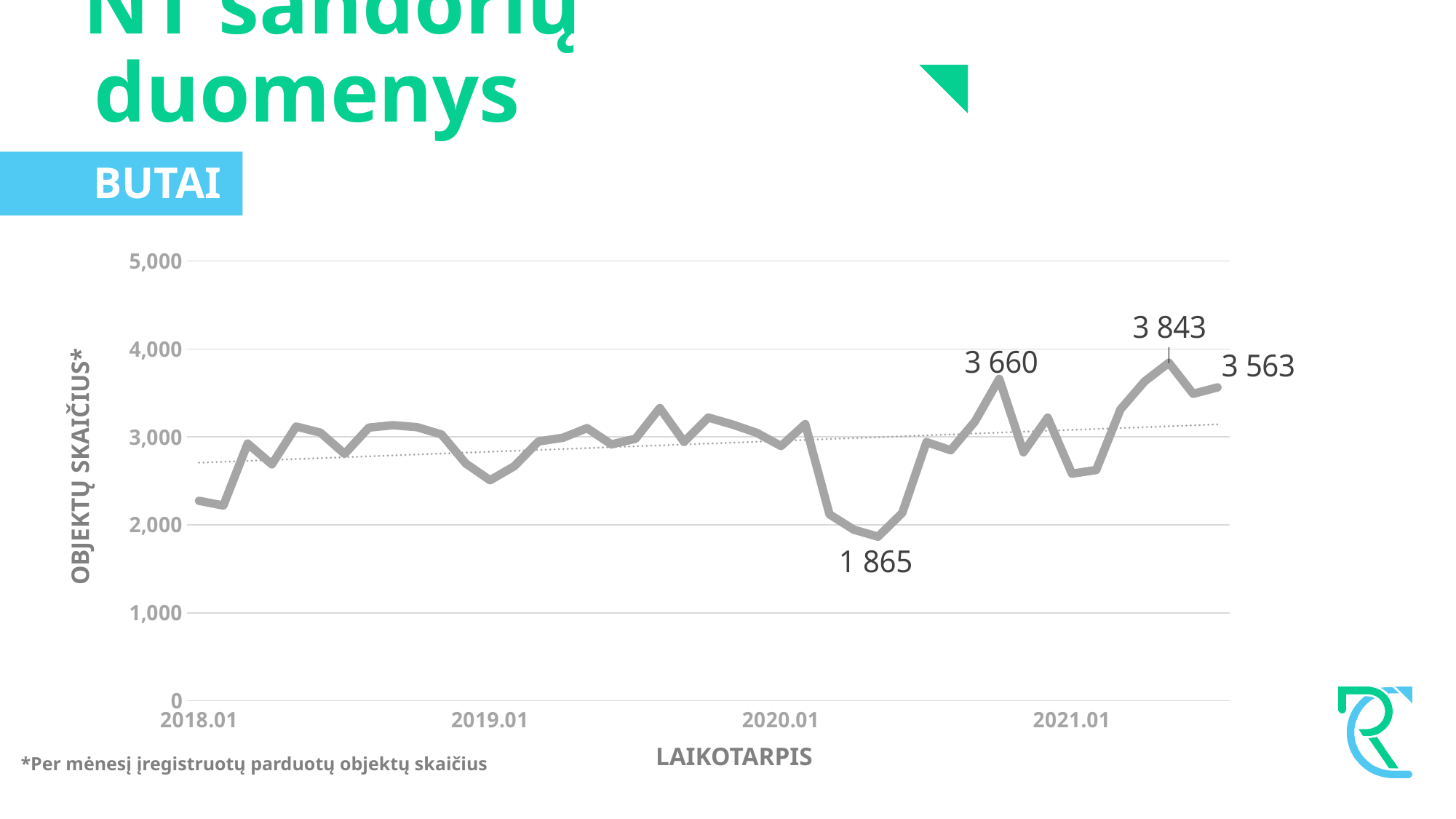
What is the highest value labelled on the chart? 3 843 Is the value at 2018.01 greater or less than 3,000? less Does the dotted trend line rise or fall from left to right? rises What is the lowest value labelled on the chart? 1 865 What kind of chart is shown on the slide? line chart What is the title of the vertical axis? OBJEKTŲ SKAIČIUS* What is the difference between the labelled peak of 3 843 and the labelled low of 1 865? 1 978 What is the last labelled value at the right end of the line? 3 563 Is the value at 2018.01 greater or less than 2,000? greater What is the title of the horizontal axis? LAIKOTARPIS Which labelled value is larger, 3 660 or 3 563? 3 660 What is the difference between the labelled values 3 843 and 3 660? 183